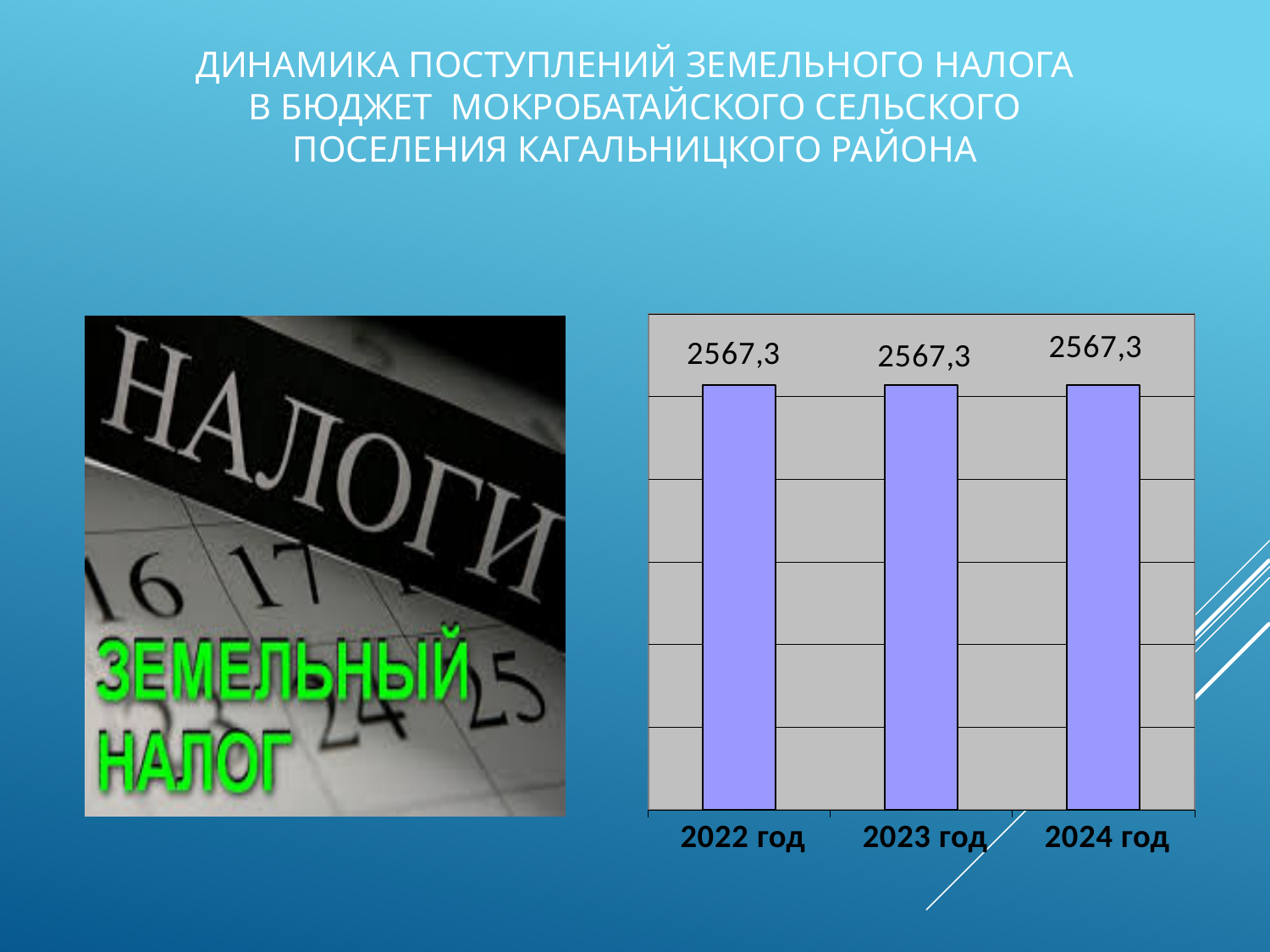
What is the difference between the values for 2024 год and 2022 год? 0 Is the value for 2023 год larger than, smaller than, or equal to the value for 2022 год? Equal Do the values rise, fall or stay the same from 2022 год to 2024 год? Stay the same What kind of chart is shown on the slide? Bar chart How many categories (years) are shown on the chart? 3 What colour are the bars in the chart? Light blue (lavender) Which year is the first category on the x axis? 2022 год What is the value for 2023 год? 2567,3 What is the value for 2024 год? 2567,3 What is the value for 2022 год? 2567,3